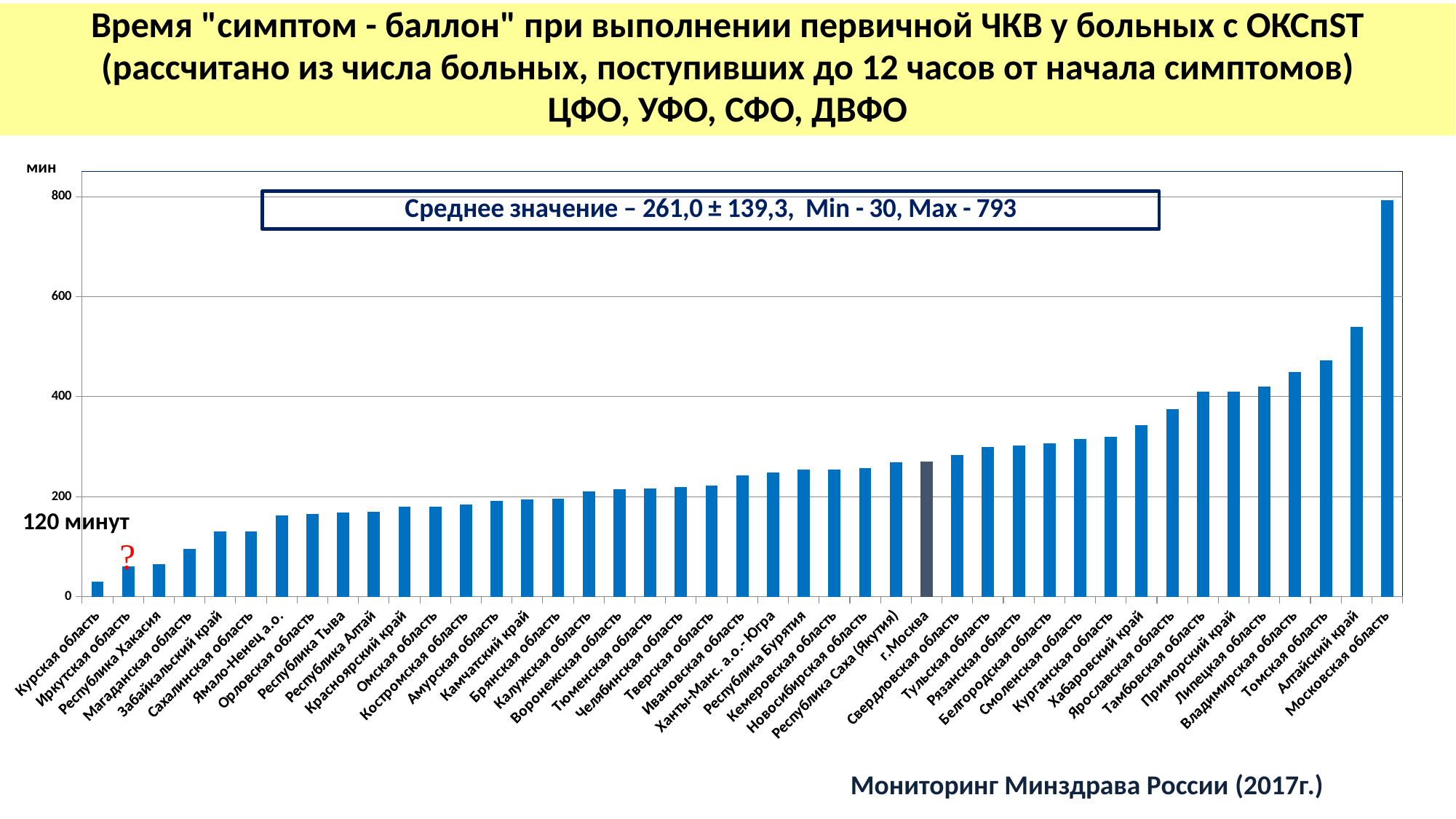
Which has the larger value, Иркутская область or Томская область? Томская область What maximum value is stated in the text box on the chart? 793 Which region has the lowest value on the chart? Курская область Is the value for Курская область greater or less than 200? less Is the value for Алтайский край greater or less than 400? greater Which has the larger value, Московская область or Алтайский край? Московская область Is the value for Московская область greater or less than 600? greater What kind of chart is shown on the slide? bar chart Which region has the highest value on the chart? Московская область What unit is shown at the top of the vertical axis? мин Do the bar values rise or fall from left to right along the x axis? rise